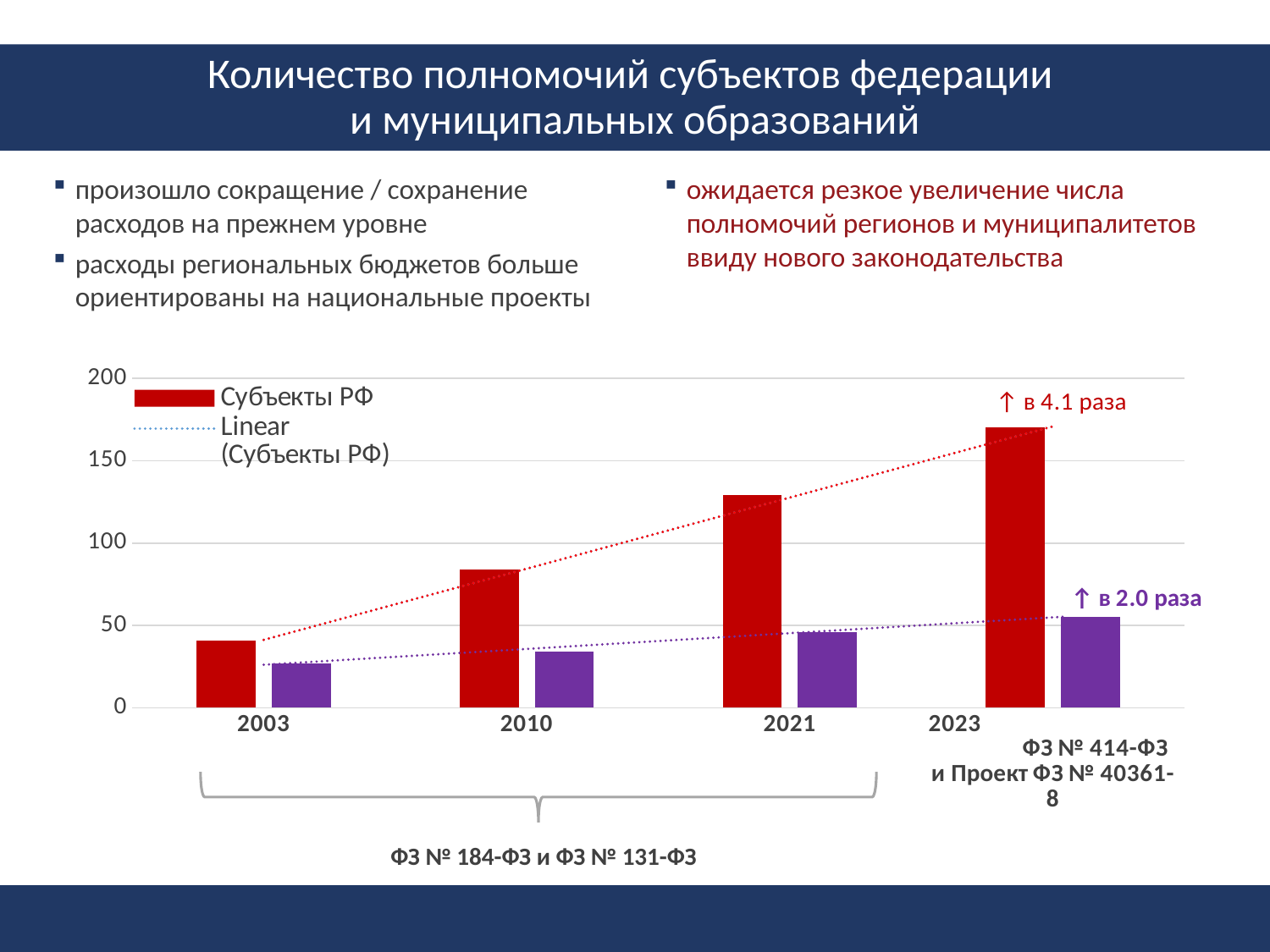
How many years are shown on the x axis of the chart? 4 Which year has the lowest value for Субъекты РФ? 2003 Which year has the highest value for Субъекты РФ? 2023 Is the value for Субъекты РФ in 2023 greater or less than 150? greater What growth factor is annotated above the red bar for 2023? в 4.1 раза Is the value for Субъекты РФ in 2010 greater or less than 100? less Do the values for Субъекты РФ rise or fall from 2003 to 2023? rise What kind of chart is shown on the slide? bar chart Is the value for Субъекты РФ in 2003 greater or less than 50? less How many entries does the chart legend list? 2 Which is larger in 2021: the red bar (Субъекты РФ) or the purple bar? the red bar (Субъекты РФ)